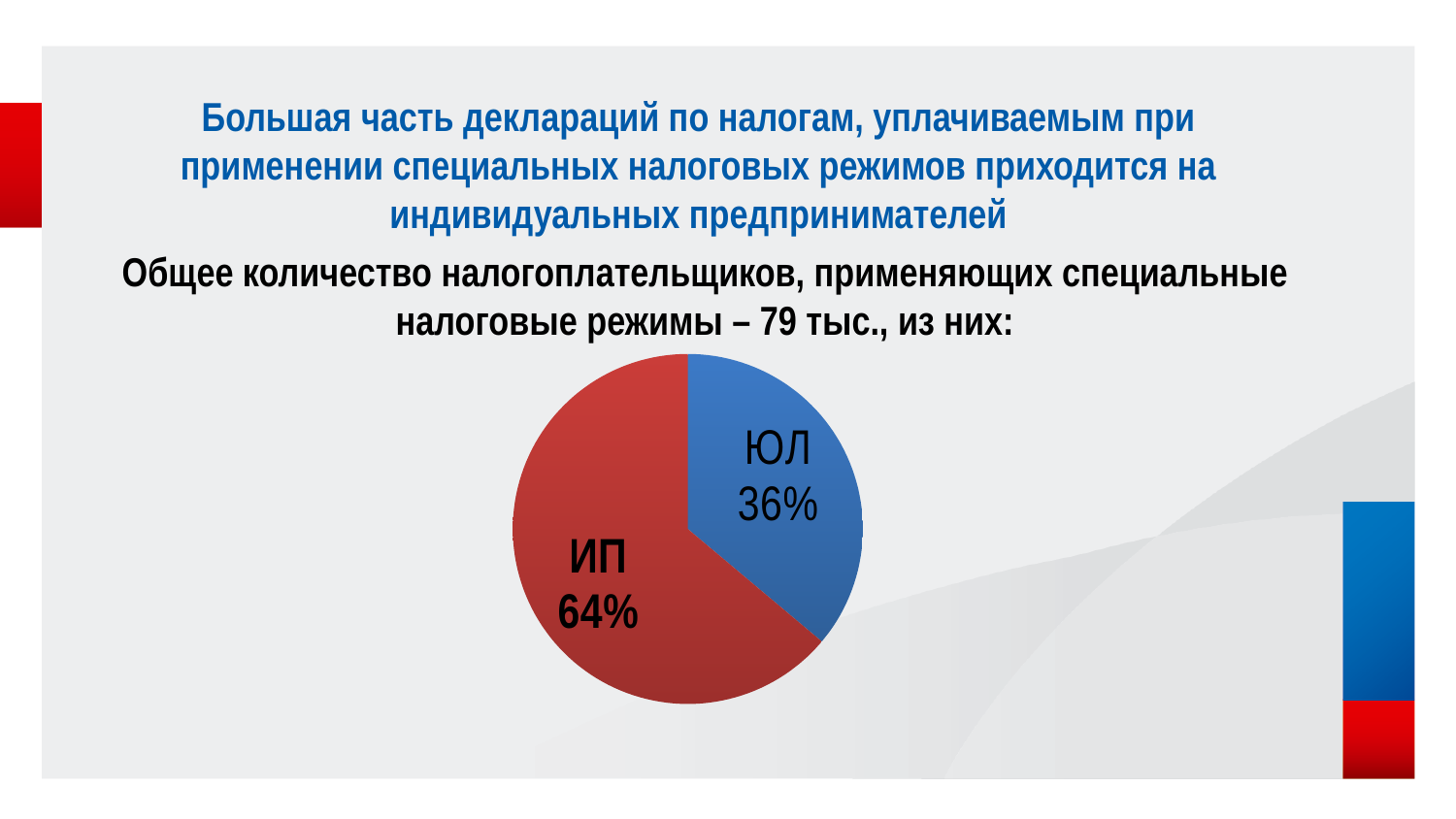
What share of the pie does ЮЛ account for? 36% What colour is the ЮЛ slice? blue Which is larger, the ИП slice or the ЮЛ slice? ИП Which slice of the pie is the largest? ИП Is the share for ЮЛ greater or less than 50%? less How many slices does the pie chart have? 2 What is the difference in percentage points between the ИП and ЮЛ slices? 28 What is the total number of taxpayers applying special tax regimes stated above the chart? 79 тыс. Which slice of the pie is the smallest? ЮЛ What share of the pie does ИП account for? 64% What kind of chart is shown on the slide? pie chart What colour is the ИП slice? red